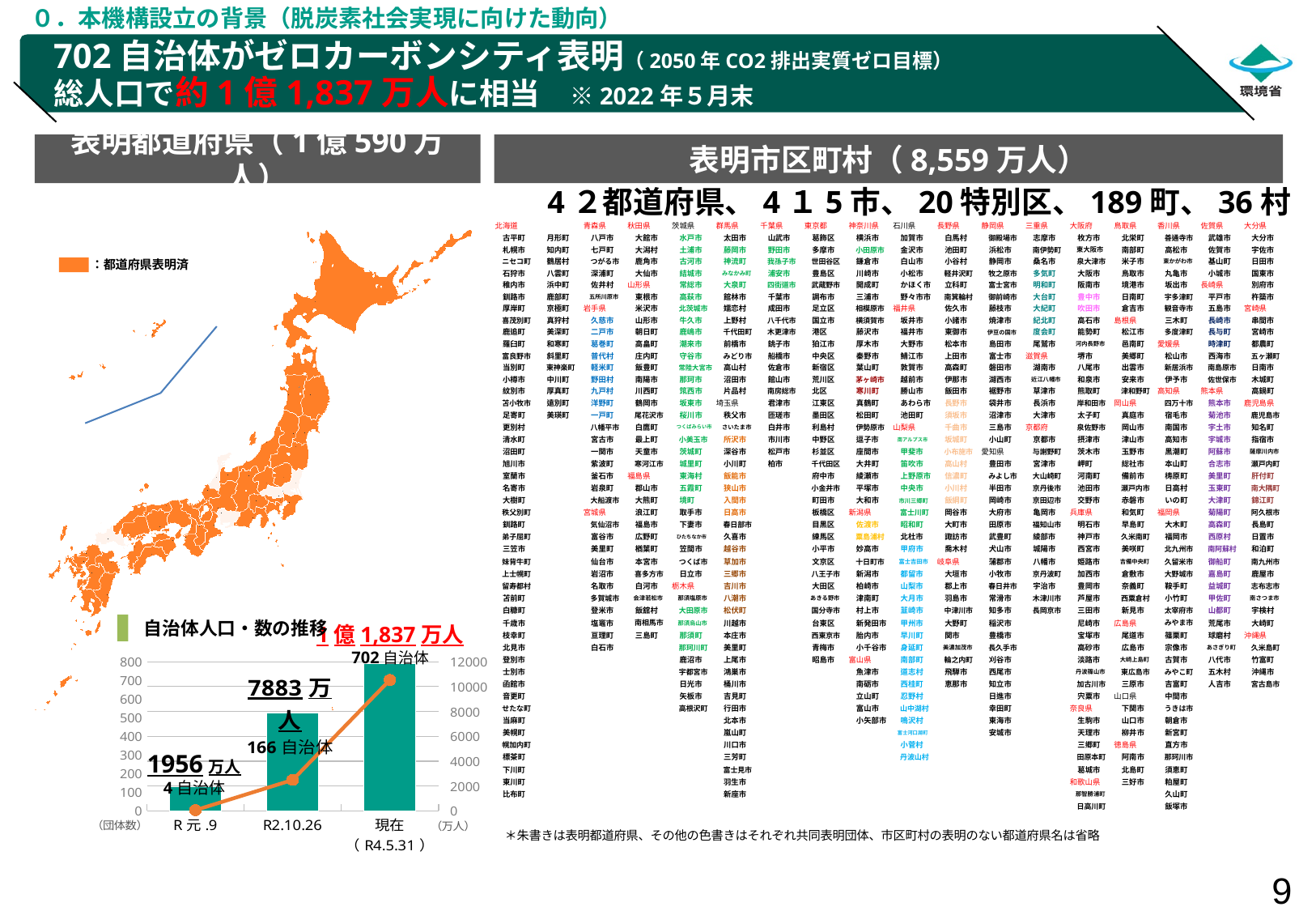
In the chart titled 自治体人口・数の推移, what is the difference in the number of municipalities between 現在 (R4.5.31) and R2.10.26? 536 In the chart titled 自治体人口・数の推移, what population is labelled for 現在 (R4.5.31)? 1 億 1,837 万人 In the chart titled 自治体人口・数の推移, do the values rise or fall from R元.9 to 現在 (R4.5.31)? rise In the chart titled 自治体人口・数の推移, which time point has the highest number of municipalities? 現在 (R4.5.31) In the chart titled 自治体人口・数の推移, what population is labelled for R元.9? 1956 万人 In the chart titled 自治体人口・数の推移, what unit is shown on the left vertical axis? 団体数 In the chart titled 自治体人口・数の推移, how many municipalities (自治体) are shown for R2.10.26? 166 自治体 In the chart titled 自治体人口・数の推移, how many time points are plotted on the x axis? 3 In the chart titled 自治体人口・数の推移, which time point has the lowest number of municipalities? R元.9 In the chart titled 自治体人口・数の推移, how many municipalities (自治体) are shown for 現在 (R4.5.31)? 702 自治体 In the chart titled 自治体人口・数の推移, how many municipalities (自治体) are shown for R元.9? 4 自治体 In the chart titled 自治体人口・数の推移, what population is labelled for R2.10.26? 7883 万人